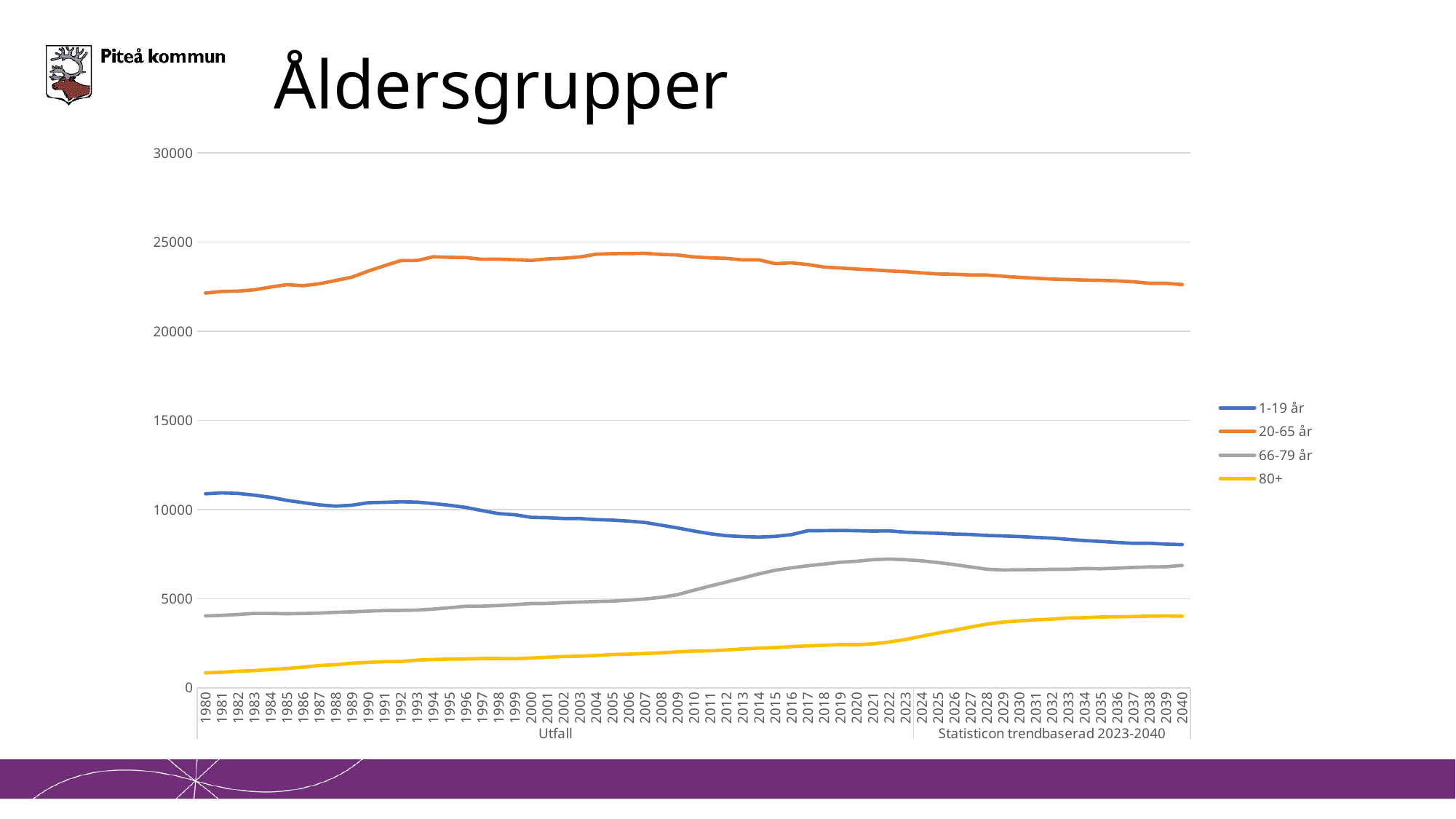
How many series does the legend list? 4 Is the value for 80+ in 1980 greater or less than 5000? less Is the value for 20-65 år in 1980 greater or less than 20000? greater Does the 80+ series rise or fall from 1980 to 2040? rise Which series has the lowest values across the whole chart? 80+ Which series has the highest values across the whole chart? 20-65 år In 1980, which is larger: the value for 1-19 år or the value for 66-79 år? 1-19 år Is the value for 1-19 år in 2040 greater or less than 10000? less Does the 1-19 år series rise or fall from 1980 to 2040? fall What is the title of the chart? Åldersgrupper What kind of chart is shown on the slide? line chart